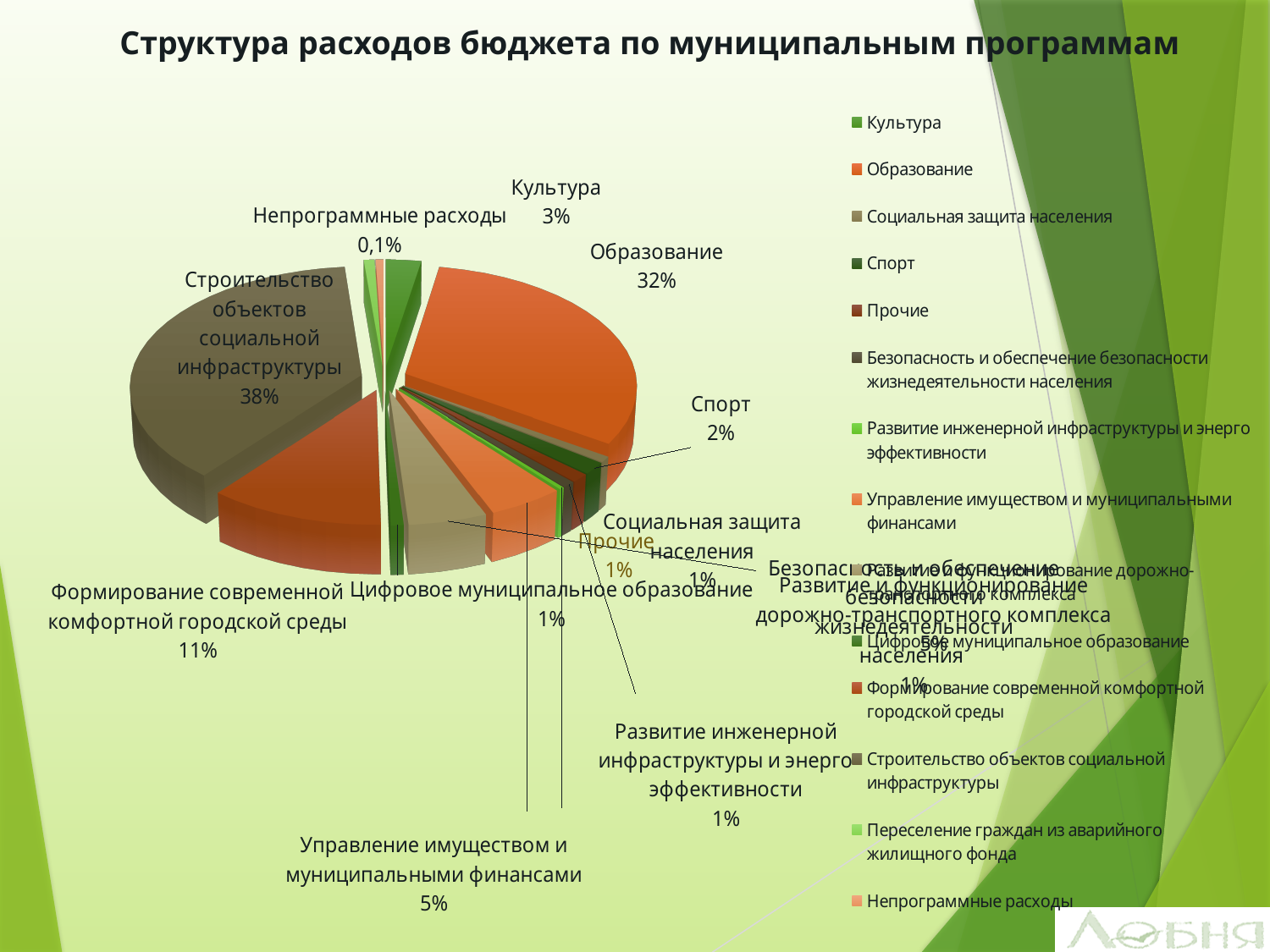
Which category has the largest share of the pie? Строительство объектов социальной инфраструктуры What is the value shown for Непрограммные расходы? 0,1% What is the value shown for Культура? 3% What is the difference in percentage points between Строительство объектов социальной инфраструктуры and Образование? 6 What share of the pie does Строительство объектов социальной инфраструктуры take? 38% Which is larger: the share for Спорт or the share for Культура? Культура What type of chart is shown on the slide? Pie chart What is the value shown for Формирование современной комфортной городской среды? 11% What share of the pie does Образование take? 32% What is the value shown for Управление имуществом и муниципальными финансами? 5% What is the title of the chart? Структура расходов бюджета по муниципальным программам Which category has the smallest share of the pie? Непрограммные расходы